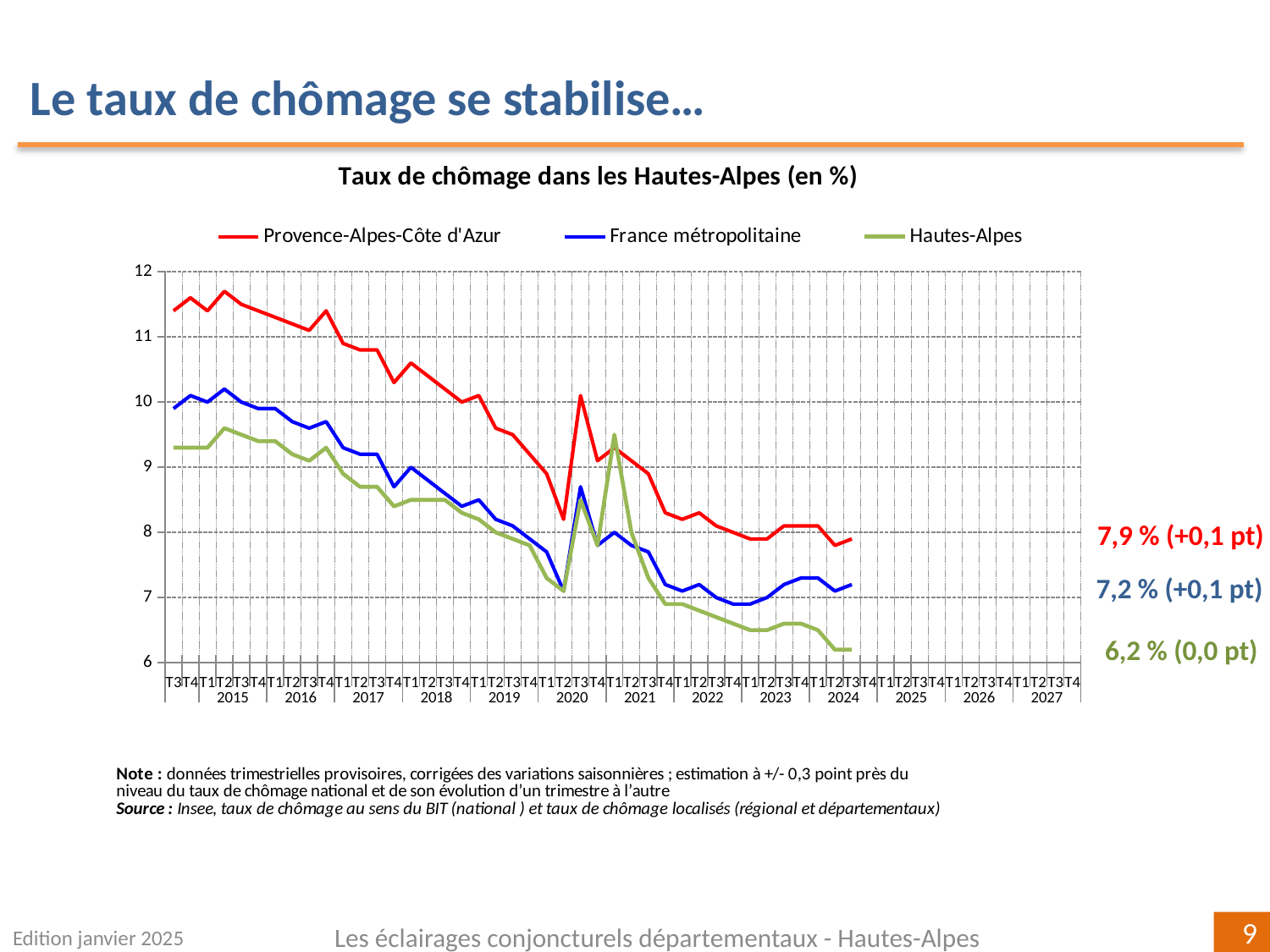
Which series has the lowest latest value? Hautes-Alpes Does the Provence-Alpes-Côte d'Azur line overall rise or fall between 2014 and 2024? fall What is the latest unemployment rate shown for Provence-Alpes-Côte d'Azur? 7,9 % Which series has the highest latest value? Provence-Alpes-Côte d'Azur What kind of chart is shown on the slide? Line chart How many series does the legend list? 3 What quarterly change is indicated next to the latest Hautes-Alpes value? 0,0 pt What is the difference between the latest values for Provence-Alpes-Côte d'Azur and France métropolitaine? 0,7 pt What is the latest unemployment rate shown for France métropolitaine? 7,2 % What is the latest unemployment rate shown for Hautes-Alpes? 6,2 % What is the title of the chart? Taux de chômage dans les Hautes-Alpes (en %) Is the value for Provence-Alpes-Côte d'Azur at the start of the series (T3 2014) greater or less than 11? greater